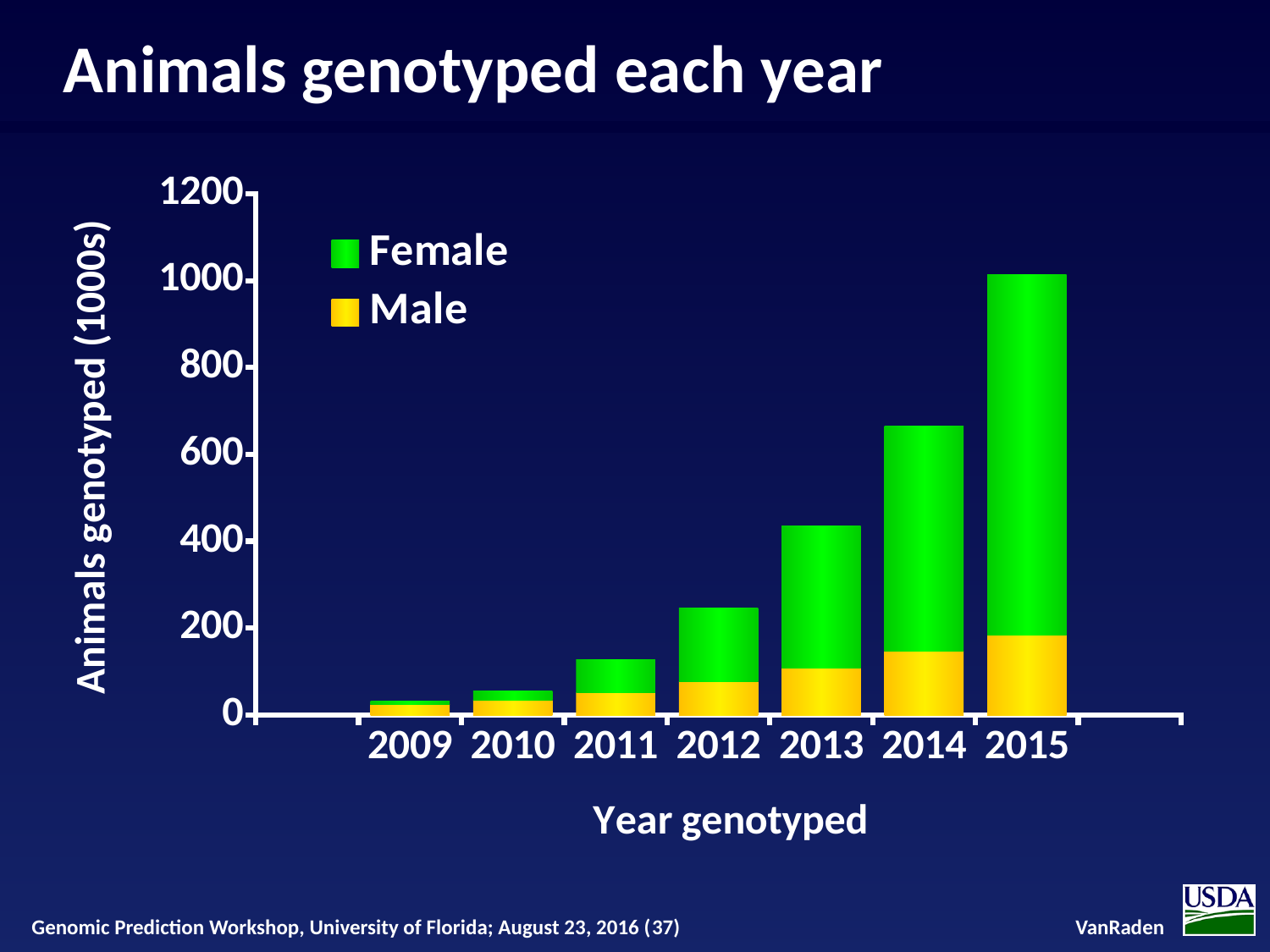
Which year has the highest total number of animals genotyped? 2015 Is the total value for 2014 greater or less than 600? greater How many years are shown on the x axis of the chart? 7 Which year has the lowest total number of animals genotyped? 2009 What is the title of the chart? Animals genotyped each year Which colour represents Female in the chart? green Do the total numbers of animals genotyped rise or fall from 2009 to 2015? rise Which year has a larger total of animals genotyped, 2013 or 2014? 2014 What kind of chart is shown on the slide? stacked bar chart Is the Male value for 2015 greater or less than 200? less Is the total value for 2011 greater or less than 200? less How many series does the chart's legend list? 2